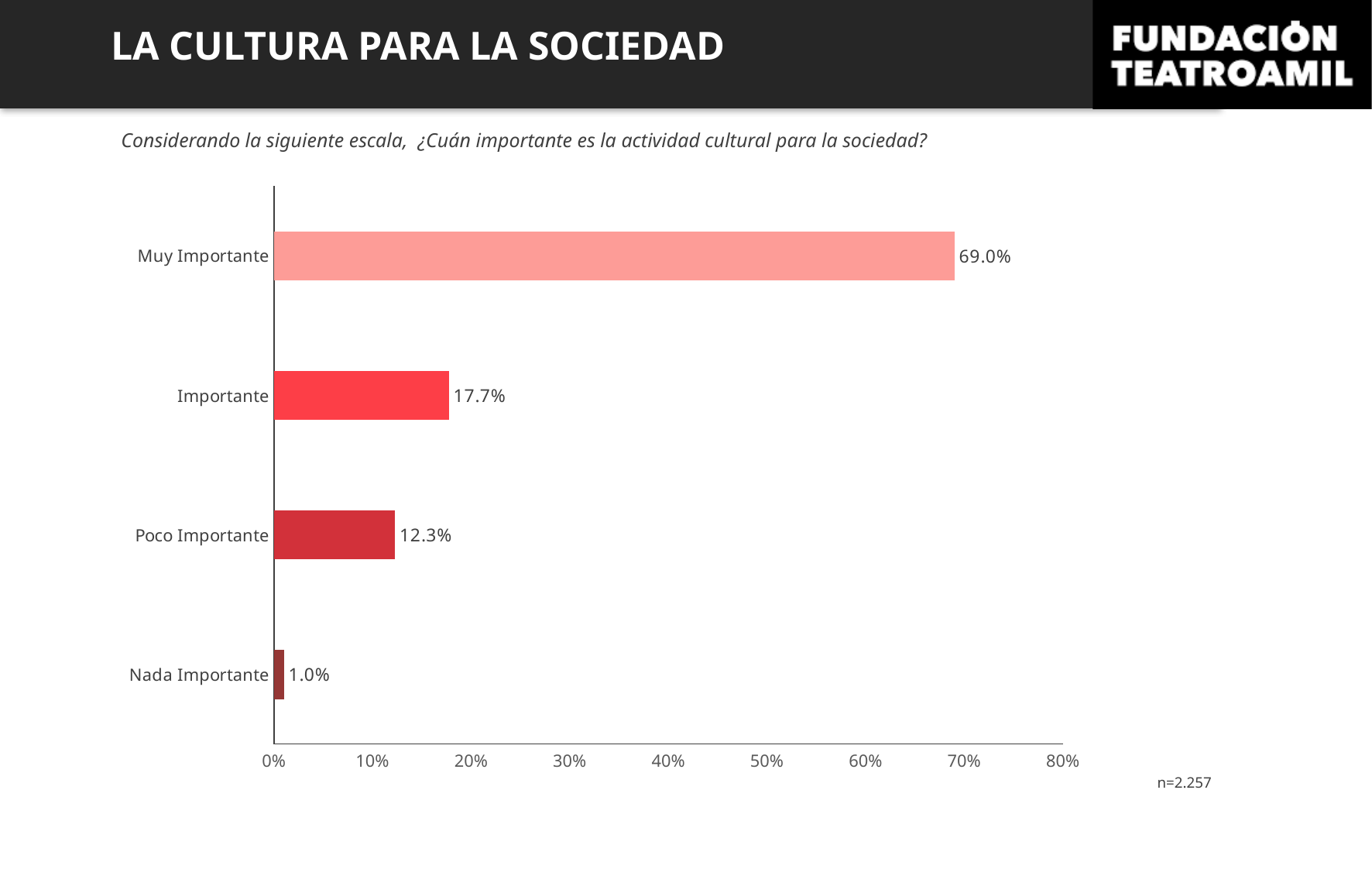
What is the difference between the values for Muy Importante and Importante? 51.3% Which is larger, the value for Importante or the value for Poco Importante? Importante What is the value for Muy Importante? 69.0% How many categories are shown in the chart? 4 What is the value for Importante? 17.7% What is the value for Poco Importante? 12.3% What kind of chart is shown on the slide? bar chart Which category has the lowest value? Nada Importante Is the value for Muy Importante greater or less than 60%? greater Which category has the highest value? Muy Importante What is the value for Nada Importante? 1.0% What is the difference between the values for Importante and Poco Importante? 5.4%